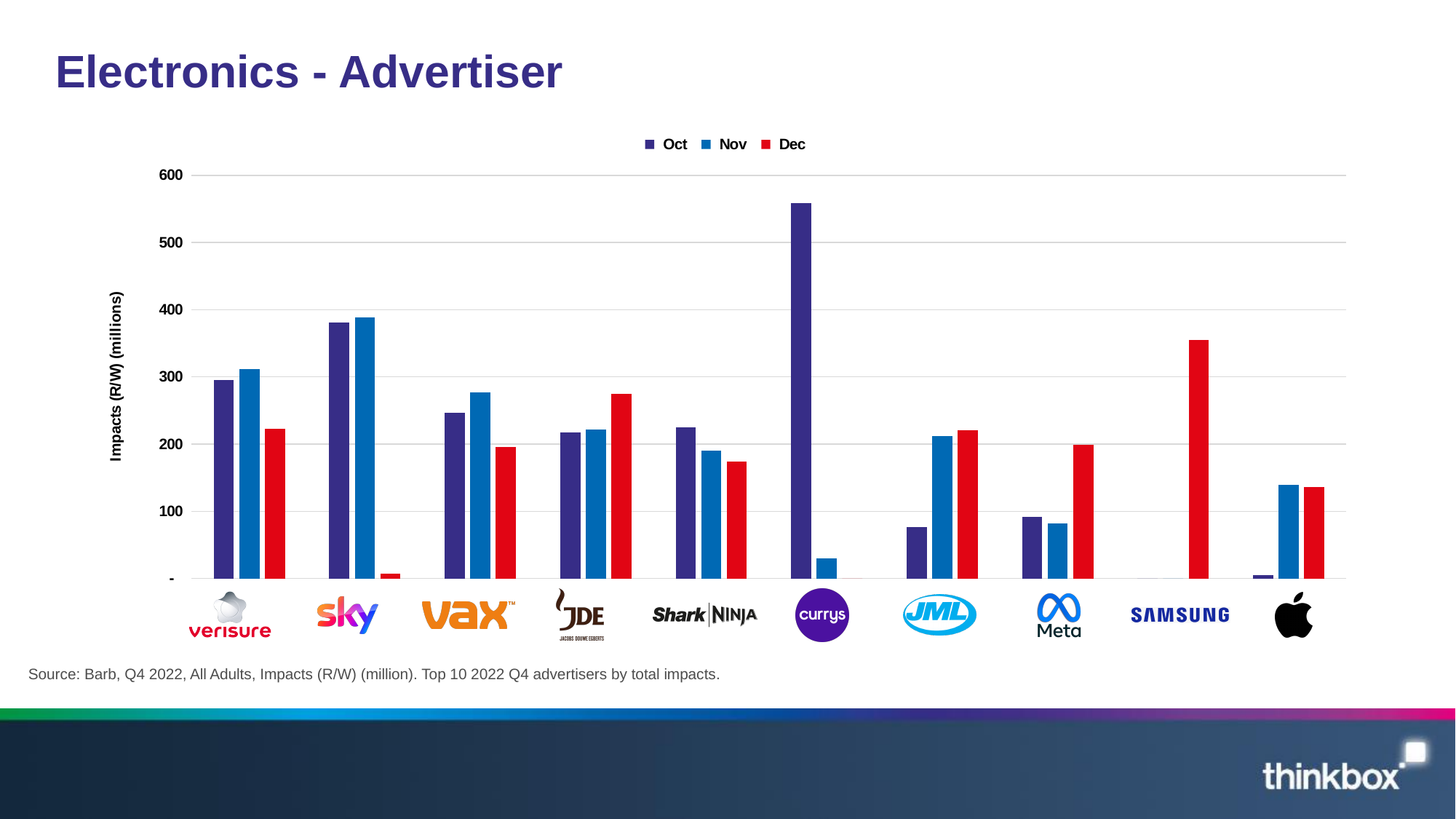
Is the Nov value for Apple greater or less than 100? greater For JDE, which is larger, the Oct value or the Dec value? Dec How many series does the legend list? 3 Is the Oct value for Currys greater or less than 500? greater Which advertiser has the tallest single bar on the chart? Currys What kind of chart is shown on the slide? Bar chart What is the label on the y axis? Impacts (R/W) (millions) How many advertisers are shown along the x axis? 10 Is the Dec value for Samsung greater or less than 300? greater For Sky, which month has the lowest bar? Dec Which is larger, the Oct value for Sky or the Oct value for Vax? Sky